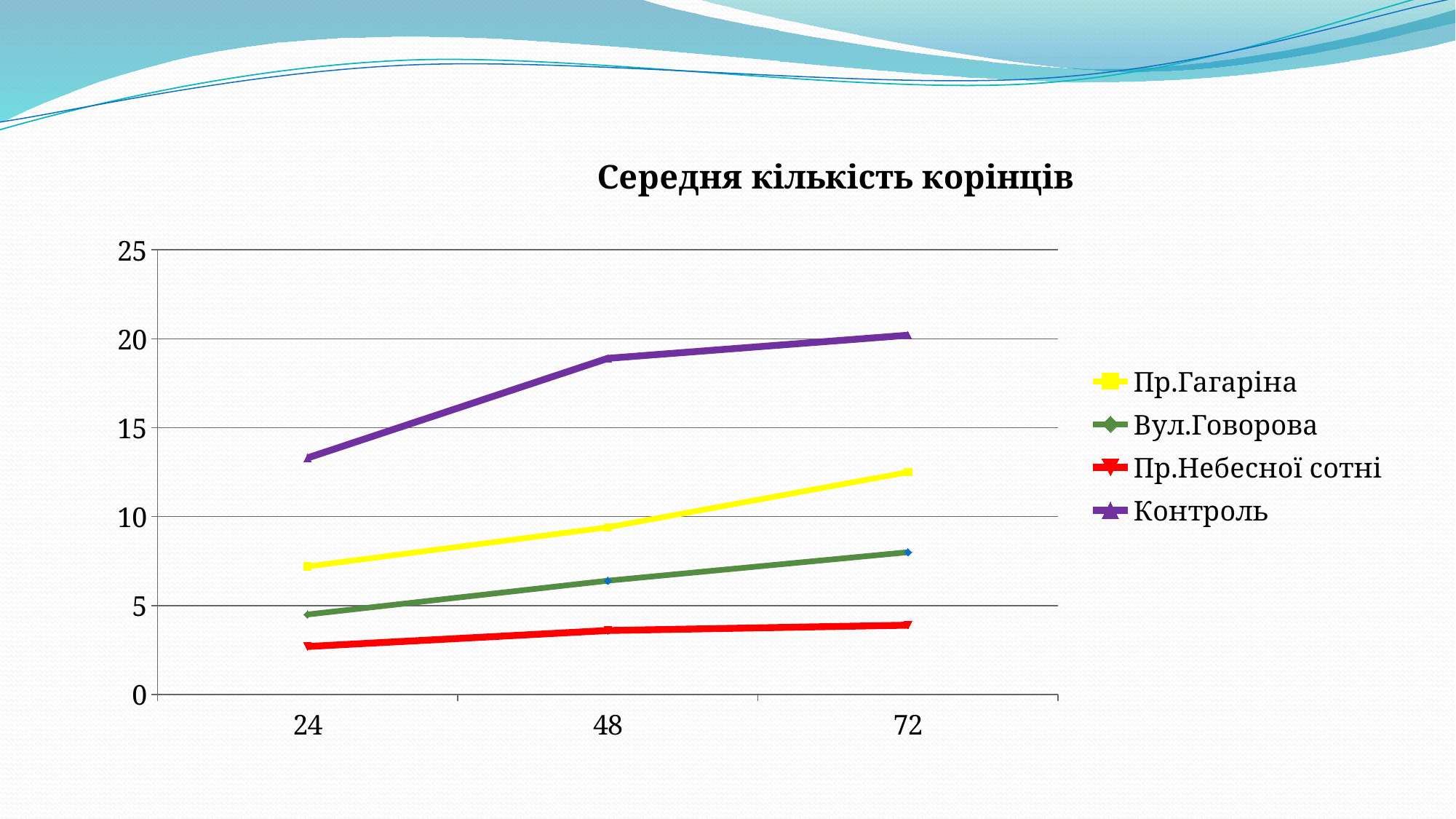
Is the value for Пр.Гагаріна at 72 greater or less than 10? greater What kind of chart is shown on the slide? line chart Which series has the highest values across the chart? Контроль Which series has the lowest values across the chart? Пр.Небесної сотні Which is larger at 72: Пр.Гагаріна or Вул.Говорова? Пр.Гагаріна How many points are there along the x axis? 3 Is the value for Вул.Говорова at 24 greater or less than 5? less Is the value for Пр.Небесної сотні at 72 greater or less than 5? less Do the values for Контроль rise or fall from 24 to 72? rise How many series does the legend list? 4 What is the title of the chart? Середня кількість корінців